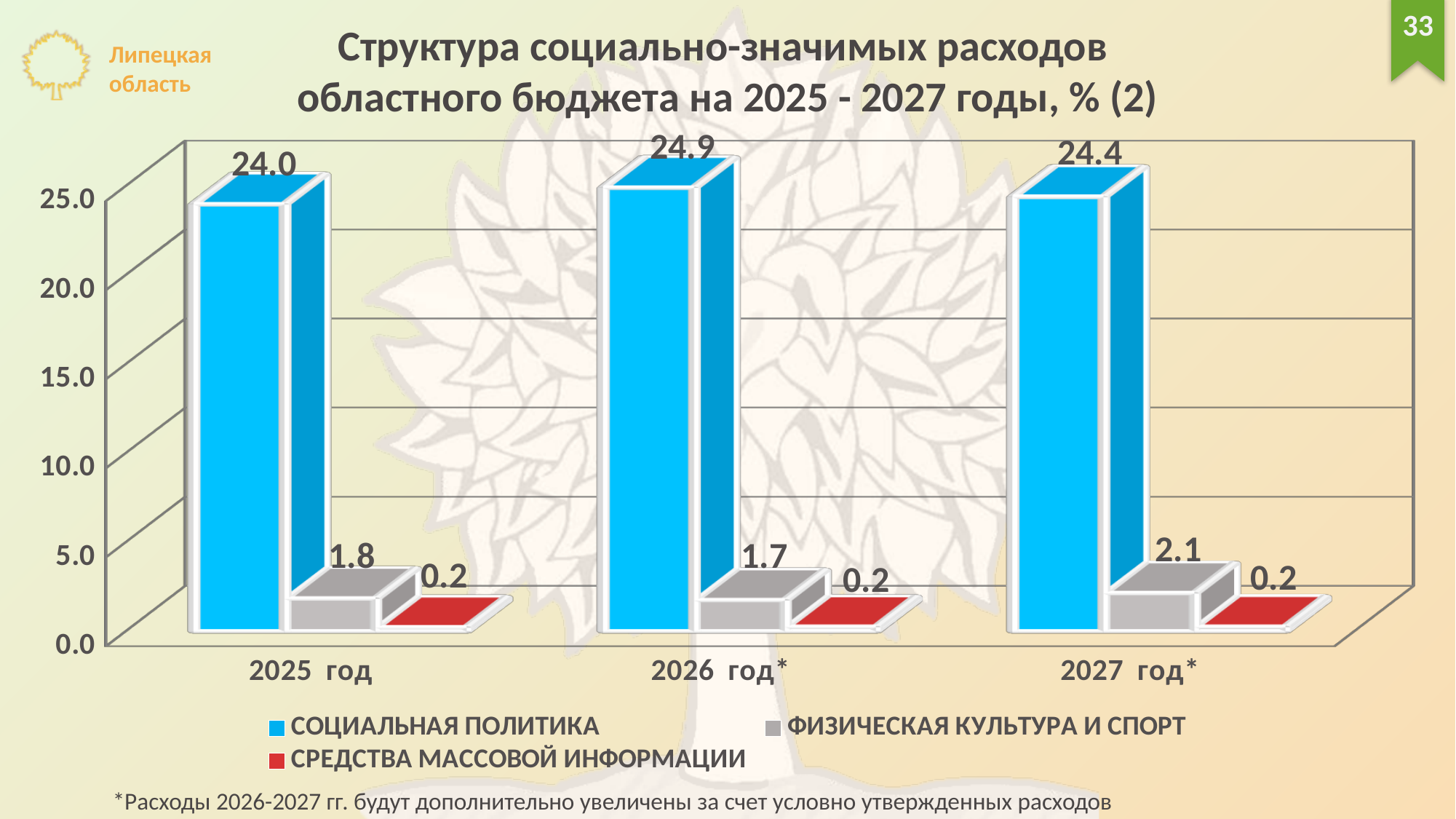
What kind of chart is shown on the slide? bar chart How many series does the legend list? 3 In which year is the value for ФИЗИЧЕСКАЯ КУЛЬТУРА И СПОРТ lowest? 2026 год* Is the value for СОЦИАЛЬНАЯ ПОЛИТИКА in 2027 год* greater or less than 20.0? greater What is the value for СОЦИАЛЬНАЯ ПОЛИТИКА in 2025 год? 24.0 In which year is the value for СОЦИАЛЬНАЯ ПОЛИТИКА highest? 2026 год* Which colour represents СРЕДСТВА МАССОВОЙ ИНФОРМАЦИИ in the legend? red What is the difference between the СОЦИАЛЬНАЯ ПОЛИТИКА values for 2026 год* and 2025 год? 0.9 What is the value for СРЕДСТВА МАССОВОЙ ИНФОРМАЦИИ in 2026 год*? 0.2 What is the value for ФИЗИЧЕСКАЯ КУЛЬТУРА И СПОРТ in 2027 год*? 2.1 How many year categories are shown on the x axis? 3 Which is larger: ФИЗИЧЕСКАЯ КУЛЬТУРА И СПОРТ in 2025 год or in 2027 год*? 2027 год*